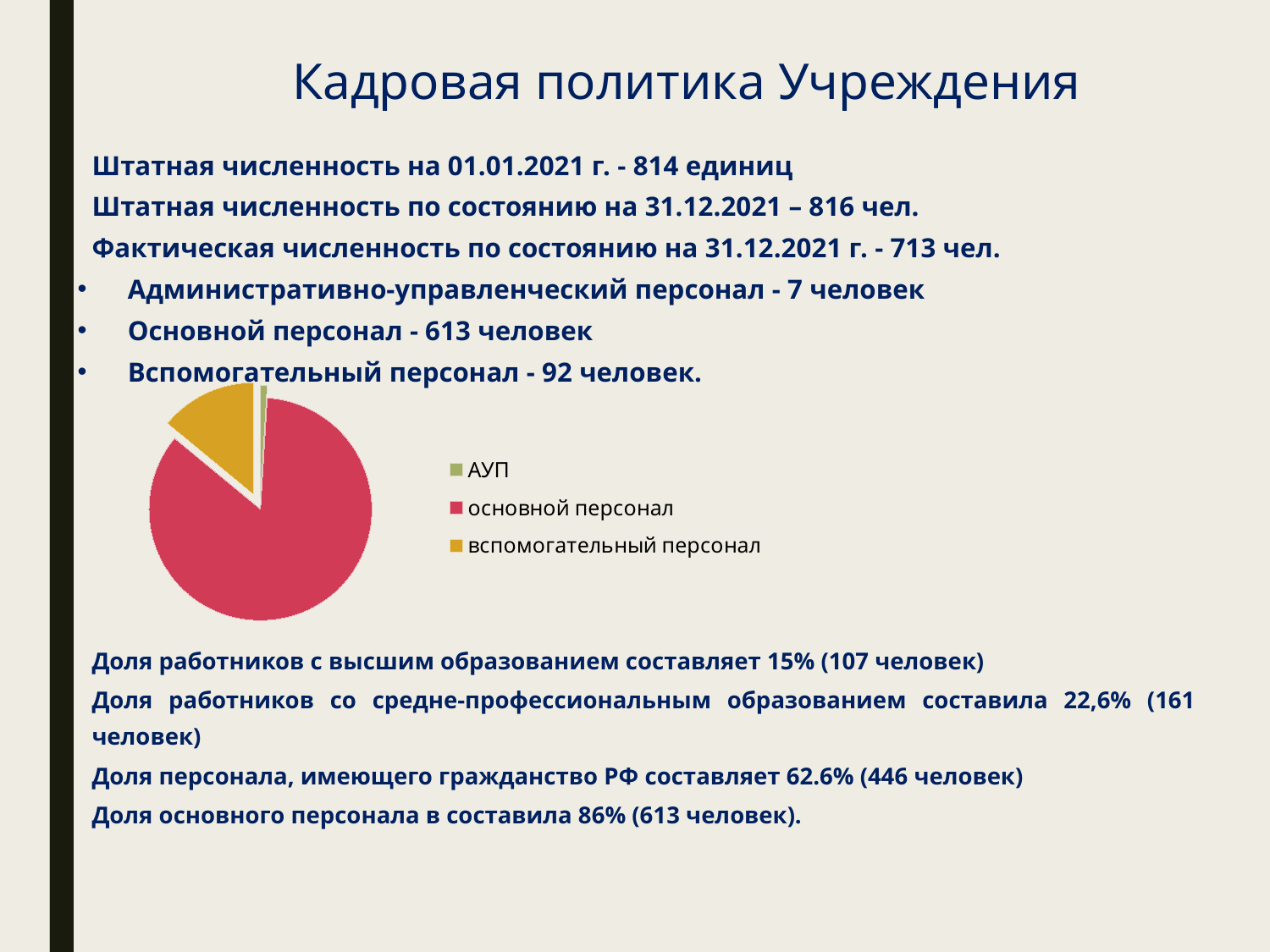
What kind of chart is shown on the slide? pie chart Which slice is larger in the pie chart: основной персонал or вспомогательный персонал? основной персонал What colour is the slice for основной персонал in the pie chart? red How many entries does the legend of the pie chart list? 3 According to the slide, how many people are in основной персонал, the largest slice of the pie chart? 613 человек What colour is the slice for вспомогательный персонал in the pie chart? yellow Which category has the smallest slice in the pie chart? АУП According to the slide, what share of the pie does основной персонал represent? 86% According to the slide, how many people are in вспомогательный персонал, the yellow slice of the pie chart? 92 человек Which slice is larger in the pie chart: вспомогательный персонал or АУП? вспомогательный персонал How many slices does the pie chart have? 3 Which category has the largest slice in the pie chart? основной персонал